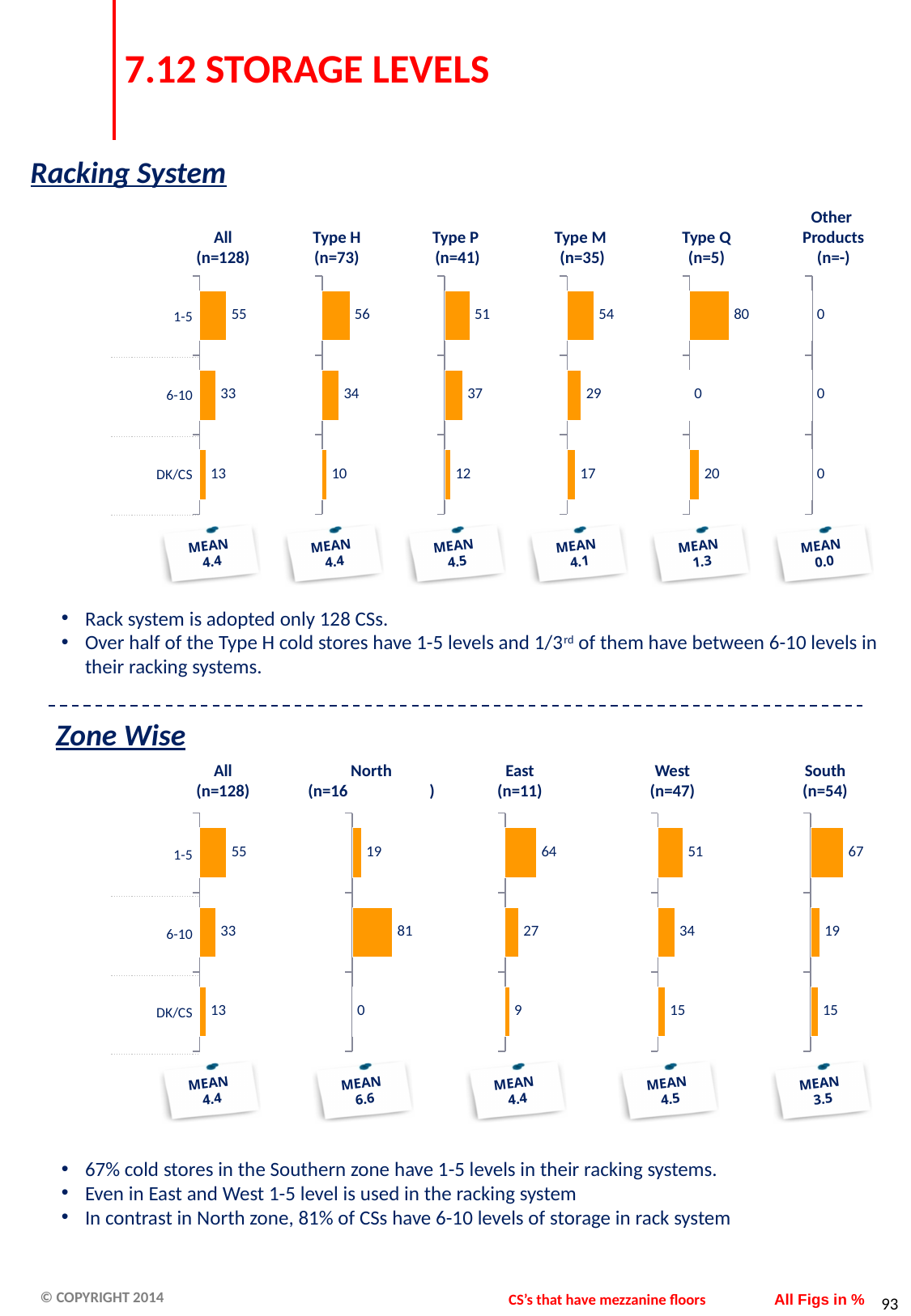
In the Zone Wise section, is the 1-5 value larger in the East (n=11) chart or the West (n=47) chart? East (n=11) In the Zone Wise section, what is the difference between the 1-5 and 6-10 values in the South (n=54) chart? 48 What type of chart is used in the Racking System section? Bar chart In the Racking System section, what is the difference between the 1-5 and 6-10 values in the All (n=128) chart? 22 In the Racking System section, which category has the highest value in the Type Q (n=5) chart? 1-5 How many categories are shown in each bar chart in the Zone Wise section? 3 In the Racking System section, what is the value for 1-5 levels in the Type H (n=73) chart? 56 In the Zone Wise section, which category has the highest value in the South (n=54) chart? 1-5 In the Racking System section, which category has the lowest value in the Type P (n=41) chart? DK/CS In the Zone Wise section, what is the MEAN shown below the North chart? 6.6 In the Zone Wise section, what is the value for 6-10 levels in the North chart? 81 In the Racking System section, what is the value for DK/CS in the Type M (n=35) chart? 17